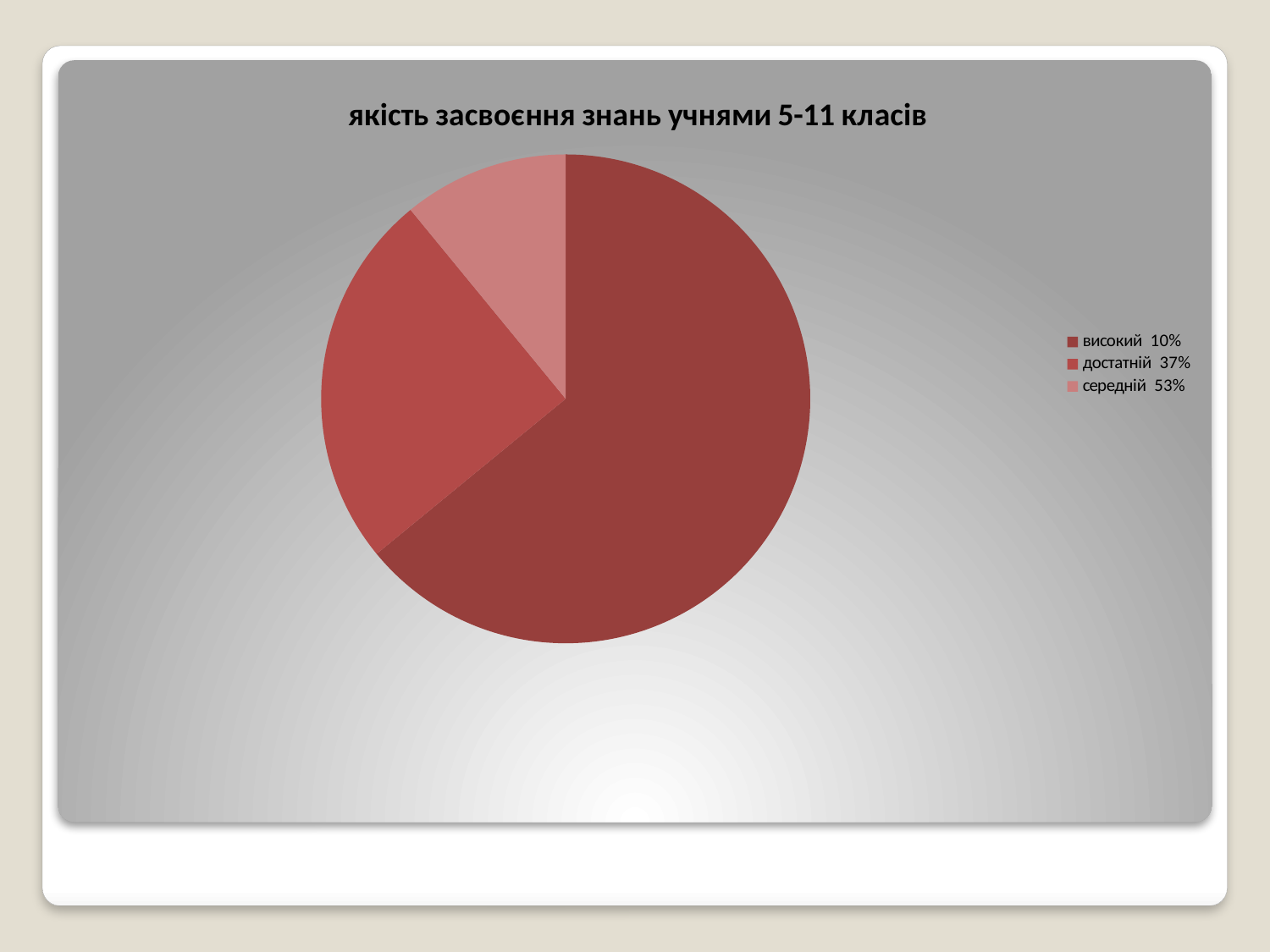
What percentage is printed in the legend next to "достатній"? 37% What percentage is printed in the legend next to "середній"? 53% What is the title of the chart? якість засвоєння знань учнями 5-11 класів What kind of chart is shown on the slide? pie chart How many slices does the pie chart have? 3 Which legend entry is listed last? середній 53% How many entries does the legend list? 3 Which legend entry is listed first? високий 10% What percentage is printed in the legend next to "високий"? 10%